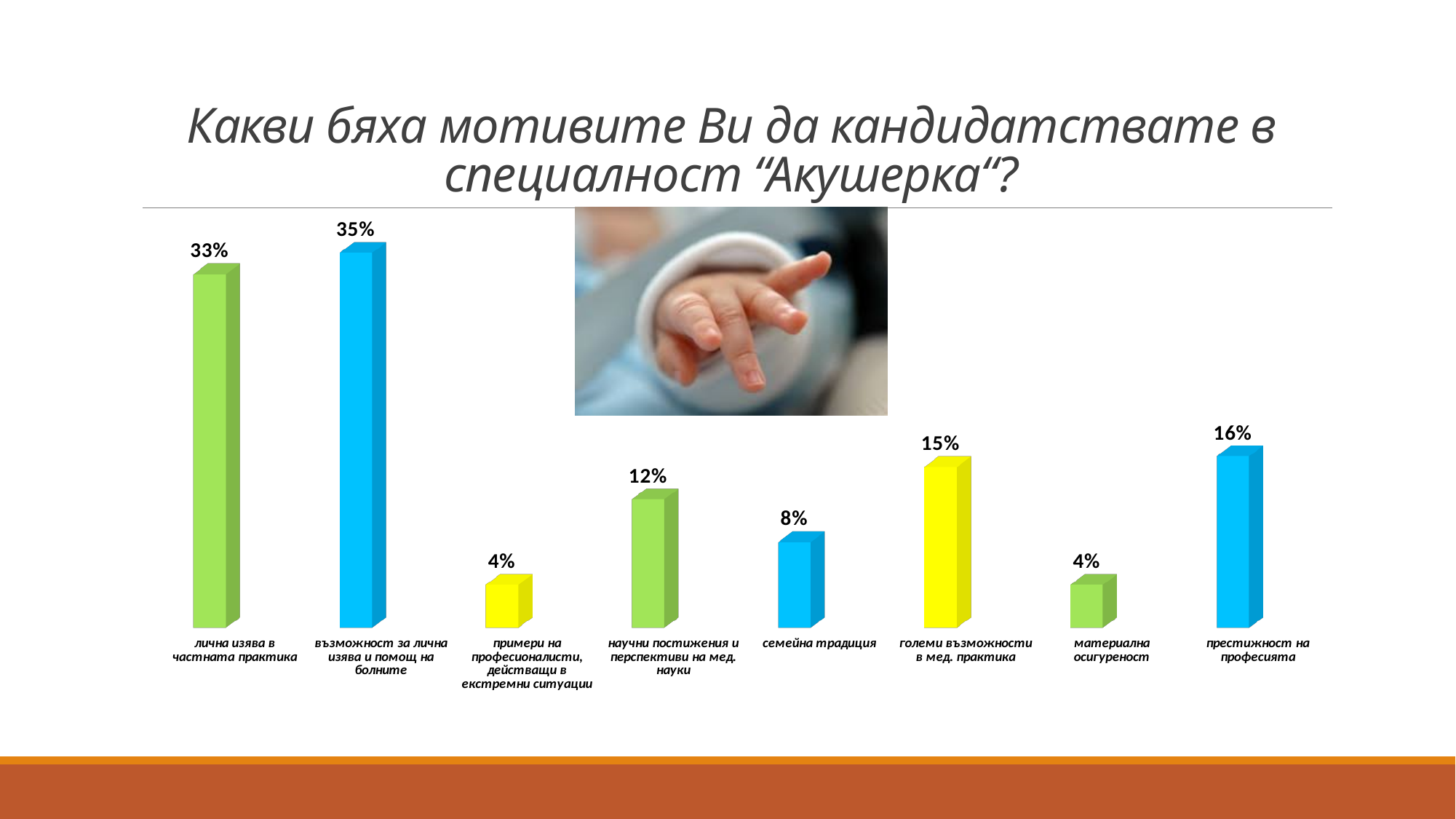
Which category has the highest value? възможност за лична изява и помощ на болните What is the value for "научни постижения и перспективи на мед. науки"? 12% What kind of chart is shown on the slide? bar chart How many categories have a value of 4%? 2 What is the title of the slide? Какви бяха мотивите Ви да кандидатствате в специалност "Акушерка"? What is the value for "семейна традиция"? 8% Which is larger: "големи възможности в мед. практика" or "престижност на професията"? престижност на професията What is the difference between "големи възможности в мед. практика" and "семейна традиция"? 7% How many categories are shown in the chart? 8 What is the value for "престижност на професията"? 16% What colour is the bar for "големи възможности в мед. практика"? yellow What is the difference between "възможност за лична изява и помощ на болните" and "лична изява в частната практика"? 2%